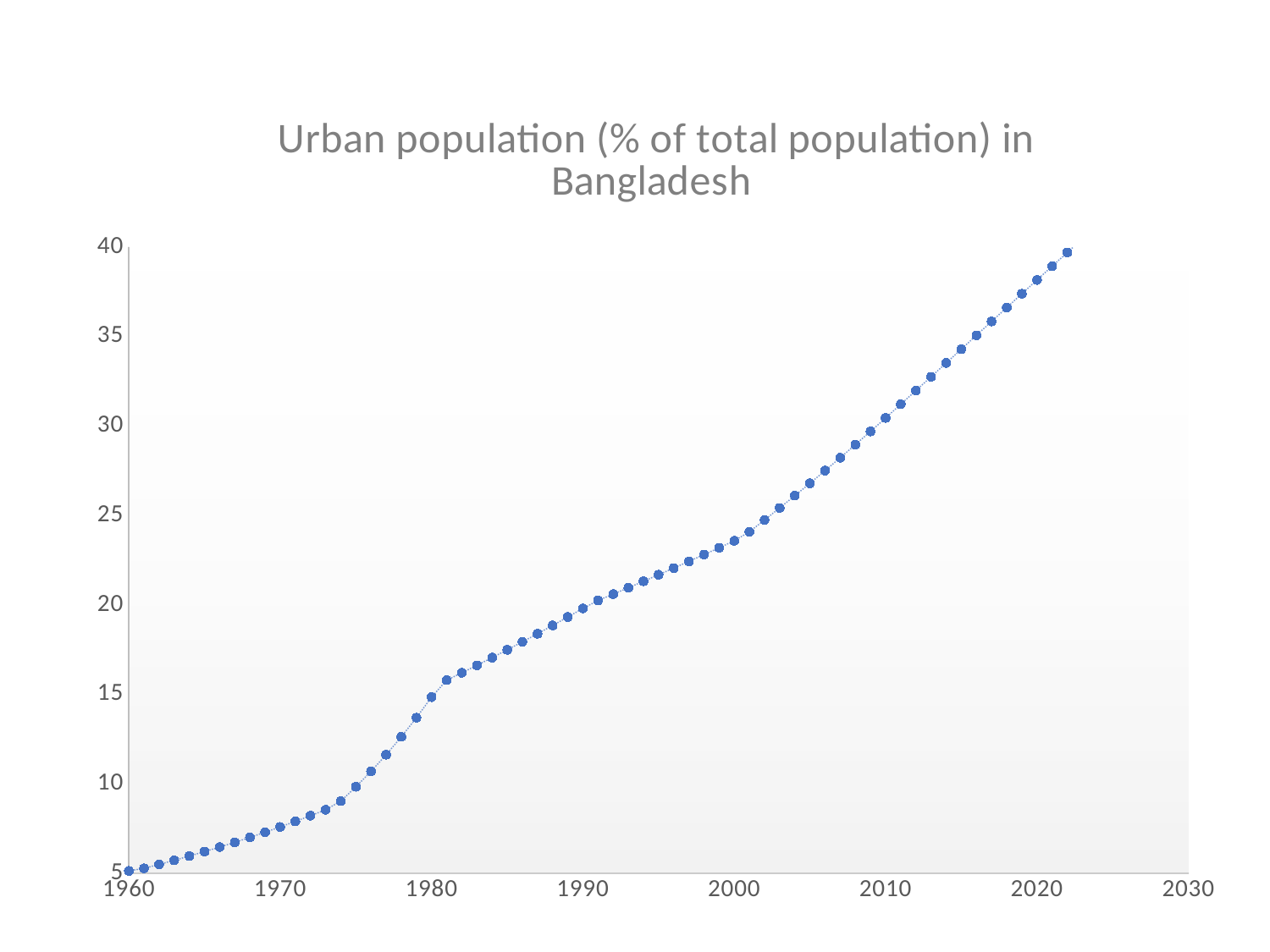
In which year is the urban population share highest? 2022 Is the value for 2022 greater or less than 35? greater What kind of chart is shown on the slide? scatter chart In which year is the urban population share lowest? 1960 Is the value for 1970 greater or less than 10? less What is the highest value shown on the vertical axis? 40 Is the value for 1960 greater or less than 10? less What is the title of the chart? Urban population (% of total population) in Bangladesh Do the values rise or fall from 1960 to 2022? rise Which year has the larger value, 1980 or 2020? 2020